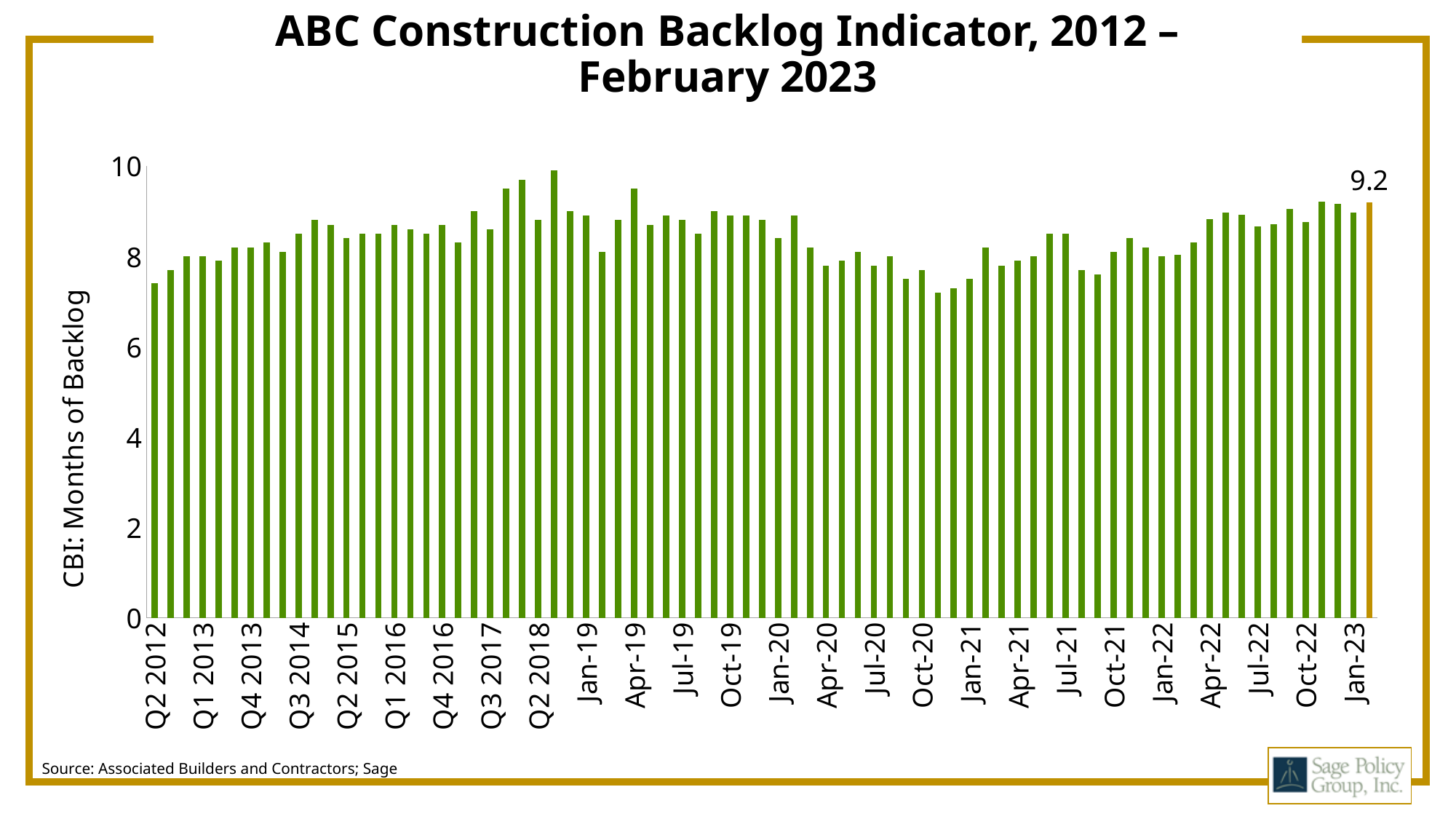
What kind of chart is shown on the slide? bar chart Do the values generally rise or fall from Oct-20 to Jan-23? rise Which is larger, the value for Oct-20 or the value for Jan-23? Jan-23 Is the value for Apr-19 greater or less than 9? greater Is the value for Oct-20 greater or less than 8? less What is the title of the vertical axis? CBI: Months of Backlog Is the value for Jul-21 greater or less than 8? greater Which is larger, the value for Q2 2012 or the final gold bar labeled 9.2? the final gold bar (9.2) What source is cited at the bottom of the slide? Associated Builders and Contractors; Sage What value is printed on the final (gold) bar at the right end of the chart? 9.2